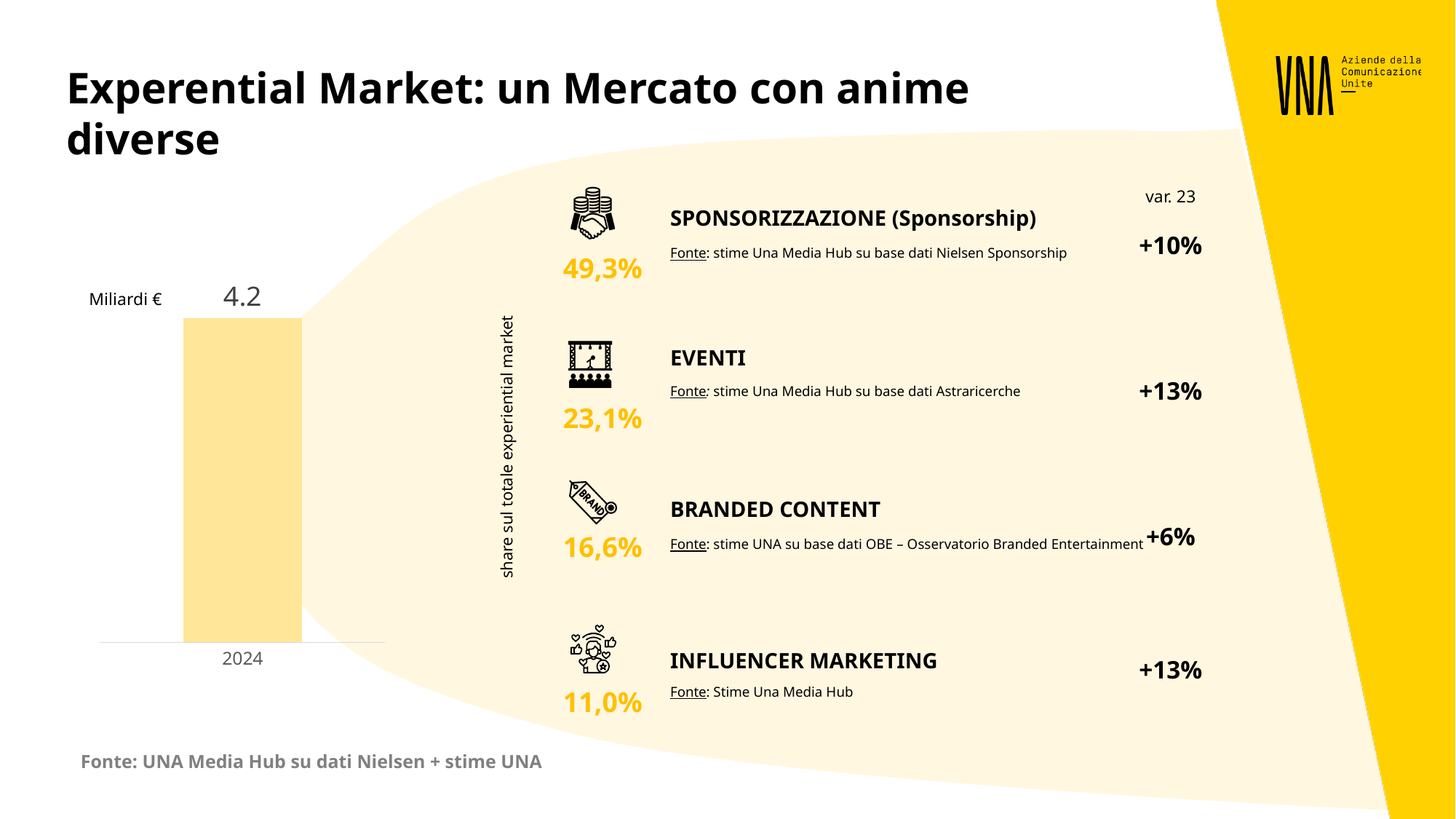
Which segment has the largest share of the experiential market? Sponsorizzazione (Sponsorship) What kind of chart is shown on the left of the slide? bar chart What share of the total experiential market is attributed to Branded Content? 16,6% How many bars does the chart on the left show? 1 What share of the total experiential market is attributed to Sponsorizzazione (Sponsorship)? 49,3% What share of the total experiential market is attributed to Eventi? 23,1% What share of the total experiential market is attributed to Influencer Marketing? 11,0% What is the difference in share between Sponsorizzazione and Eventi? 26,2% Which segment has the smallest share of the experiential market? Influencer Marketing What unit is indicated next to the bar chart? Miliardi € What value is shown for the 2024 bar in the chart on the left? 4.2 What is the category label on the x axis of the bar chart? 2024